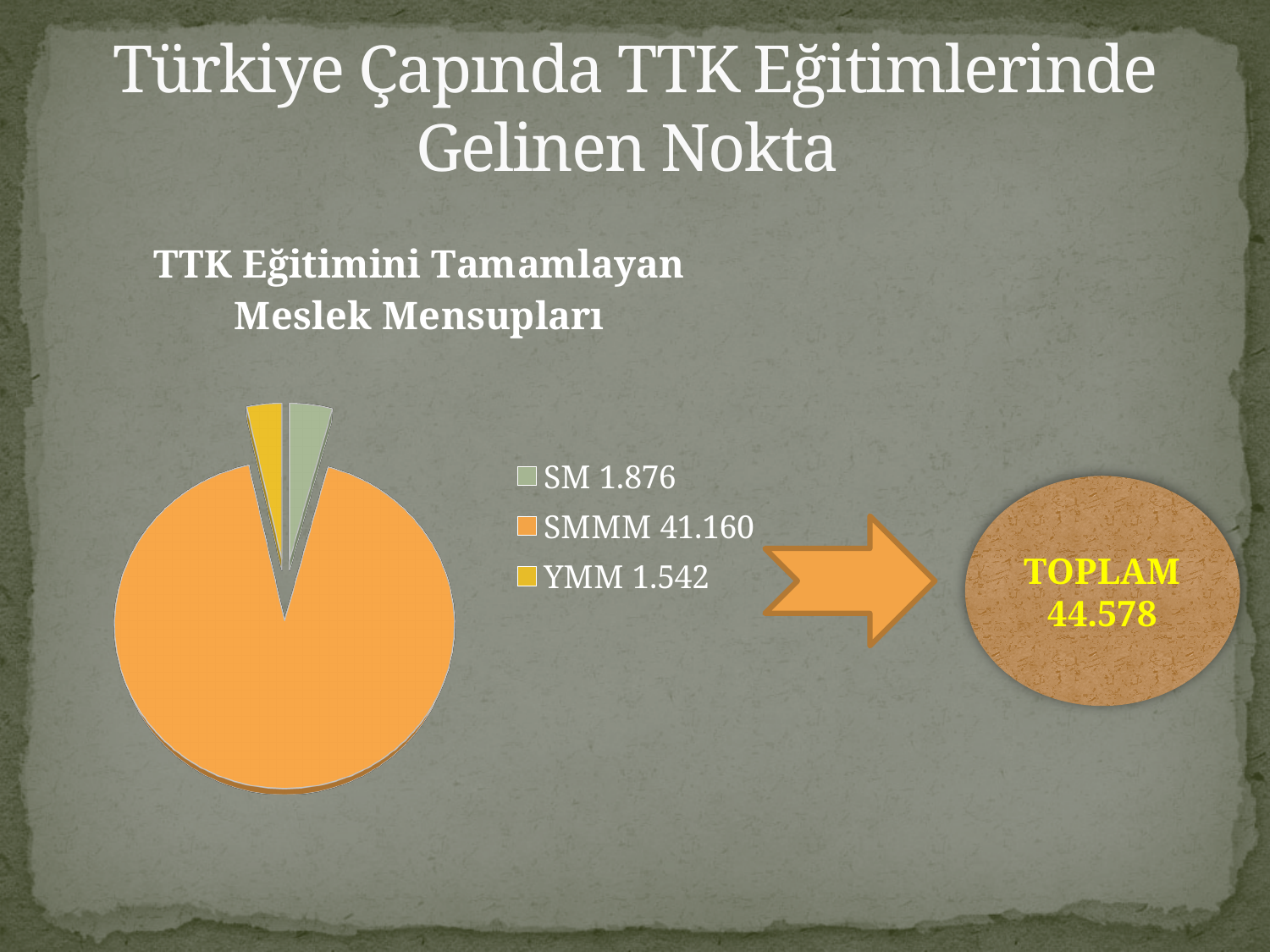
Which is larger, the value for SM or the value for YMM? SM What is the value for SMMM in the chart? 41.160 How many categories does the pie chart have? 3 What is the title of the chart? TTK Eğitimini Tamamlayan Meslek Mensupları Which category has the smallest slice of the pie? YMM What is the value for SM in the chart? 1.876 What is the difference between the values for SMMM and SM? 39.284 What kind of chart is shown on the slide? Pie chart What is the value for YMM in the chart? 1.542 What is the difference between the values for SM and YMM? 334 Which category has the largest slice of the pie? SMMM What is the total of all three categories shown on the slide? 44.578